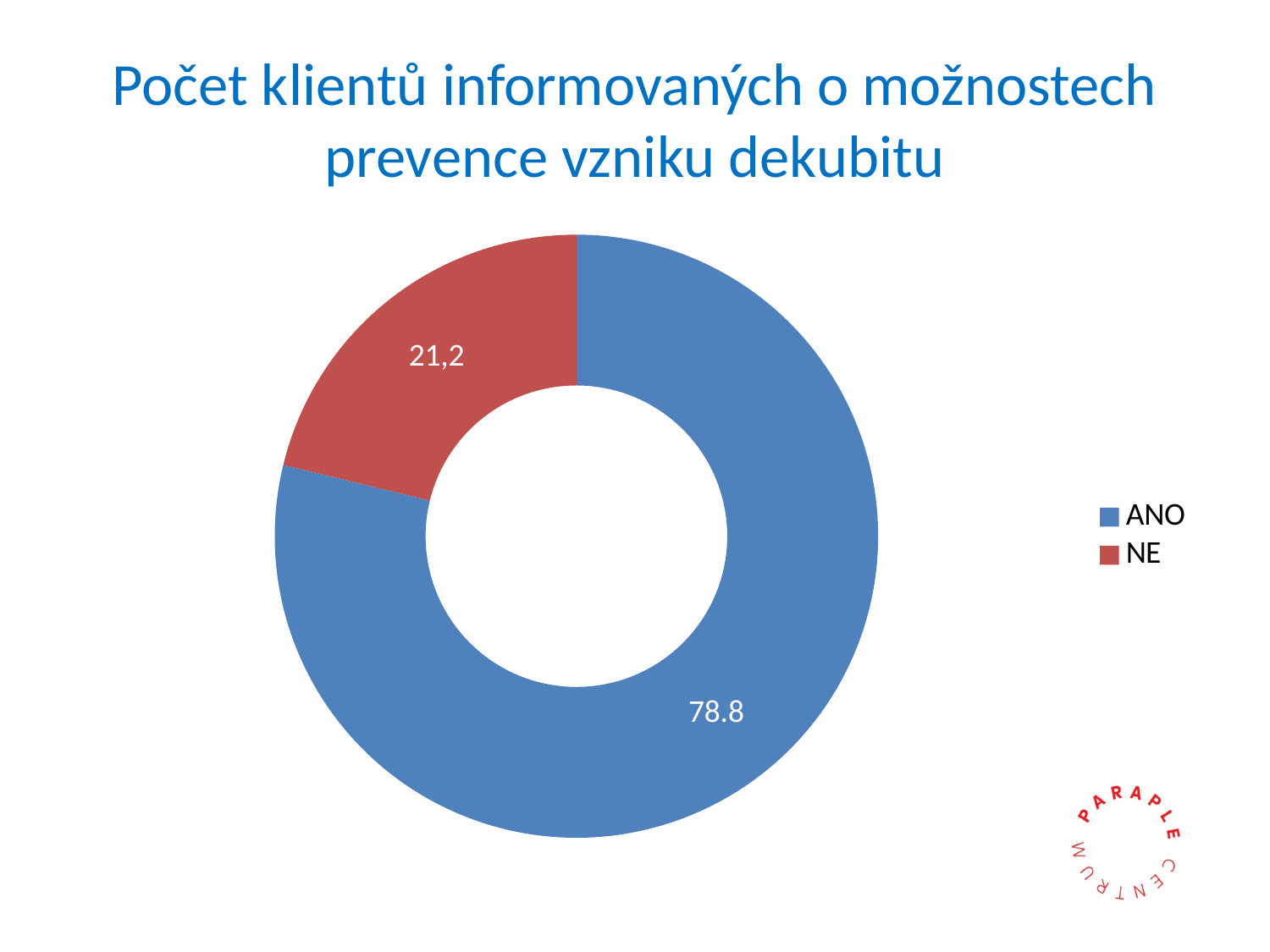
How many entries does the legend list? 2 What is the title of the chart? Počet klientů informovaných o možnostech prevence vzniku dekubitu Which category has the largest slice? ANO Which category has the smallest slice? NE What colour is the slice for NE? Red How many categories does the chart show? 2 What value is shown for ANO? 78.8 What kind of chart is shown on the slide? Doughnut (pie) chart Which is larger, the value for ANO or the value for NE? ANO What value is shown for NE? 21,2